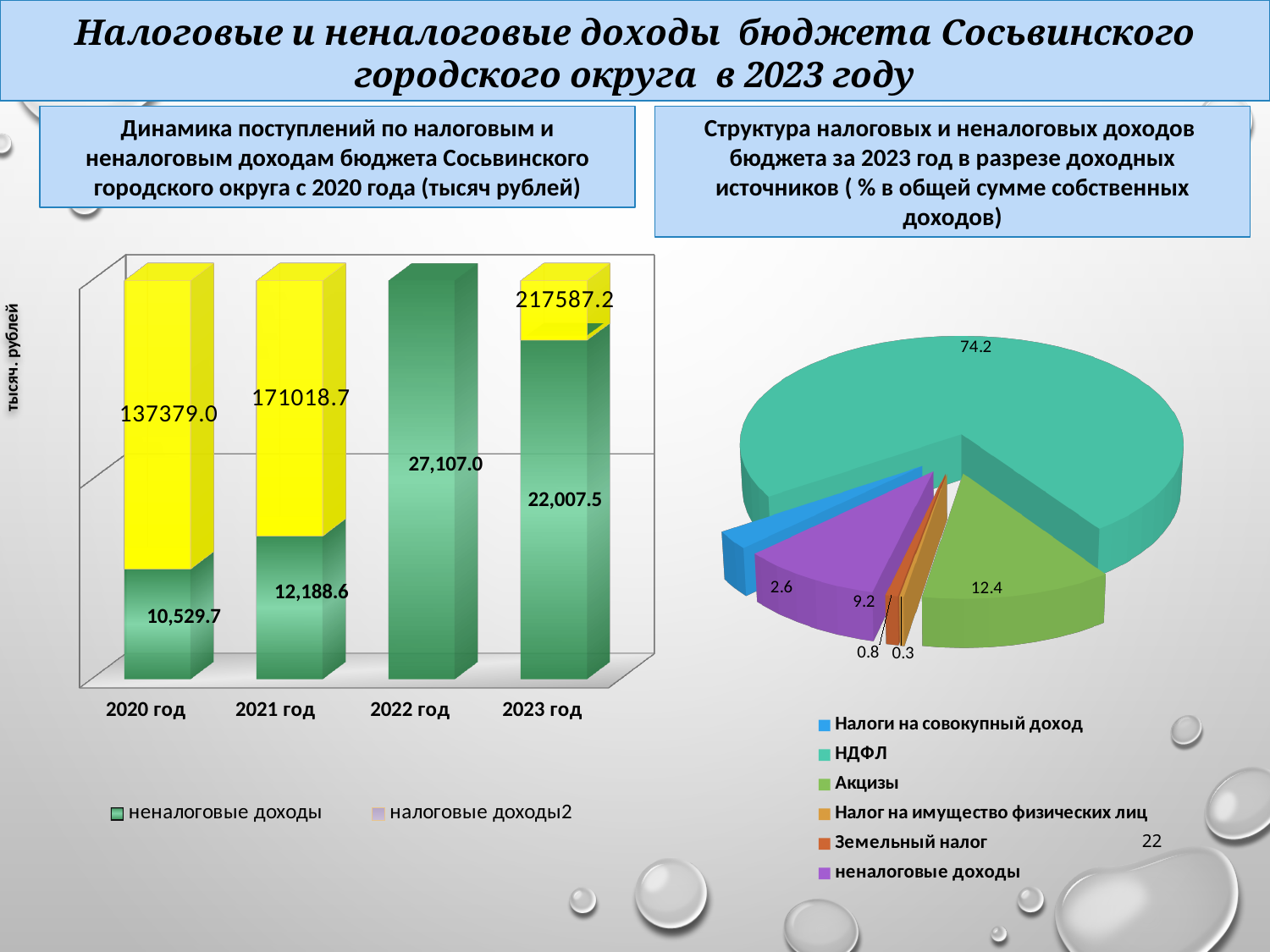
In the left chart, how many years are shown on the x axis? 4 In the left chart, how many series does the legend list? 2 In the left chart, what is the value of налоговые доходы2 for 2023 год? 217587.2 In the left chart, which year has the highest value of неналоговые доходы? 2022 год In the left chart, what is the value of неналоговые доходы for 2020 год? 10,529.7 What kind of chart is the left chart, 'Динамика поступлений по налоговым и неналоговым доходам'? Bar chart In the left chart, what is the difference between налоговые доходы2 in 2021 год and 2020 год? 33639.7 In the left chart, which is larger: неналоговые доходы in 2021 год or in 2020 год? 2021 год What kind of chart is the right chart, 'Структура налоговых и неналоговых доходов бюджета за 2023 год'? Pie chart In the right pie chart, how many income sources does the legend list? 6 In the right pie chart, which income source has the largest slice? НДФЛ In the right pie chart, what share does НДФЛ have? 74.2